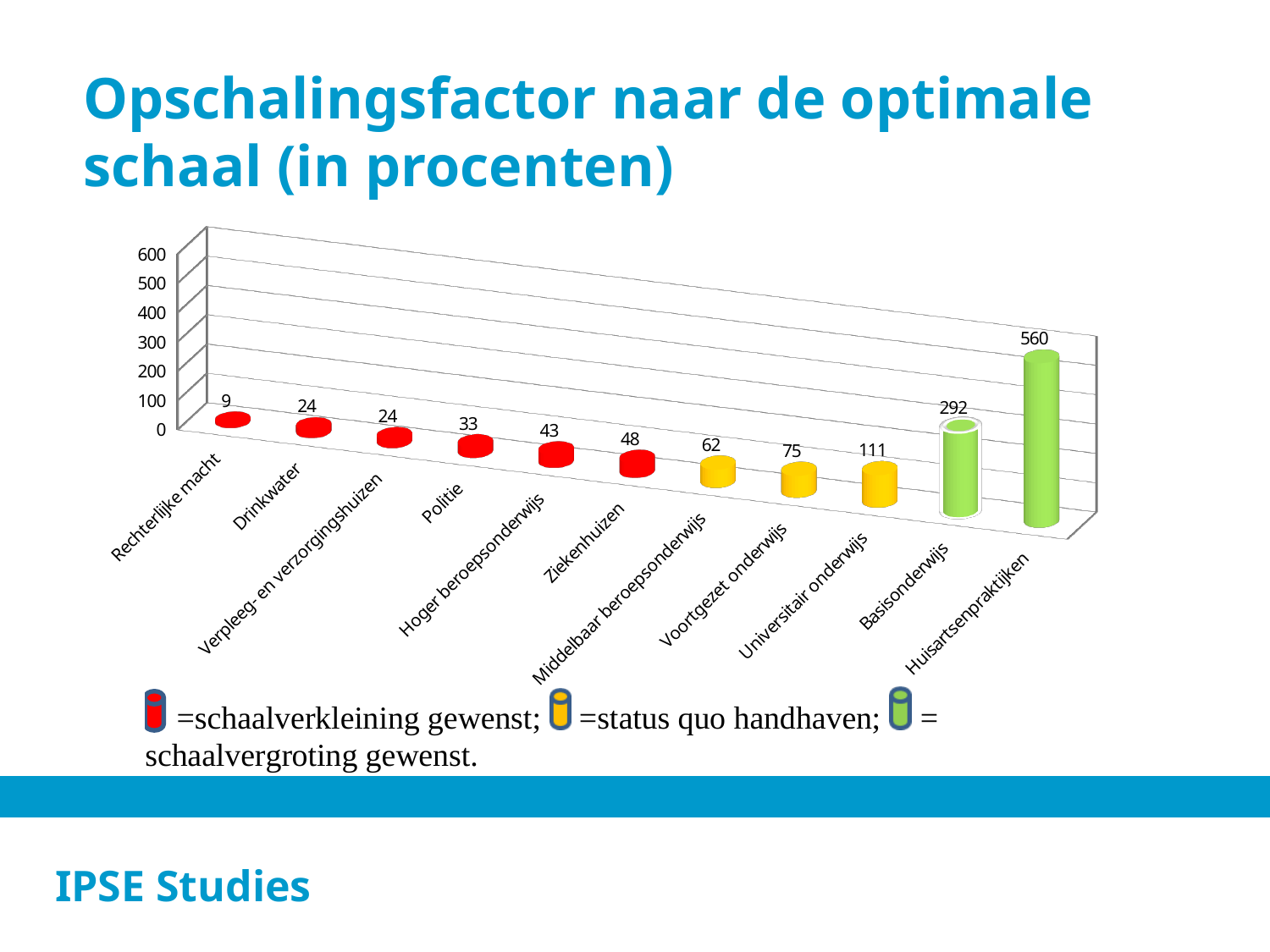
Do the values rise or fall from left to right along the x axis? Rise Which category has the highest value? Huisartsenpraktijken What colour are the bars for Basisonderwijs and Huisartsenpraktijken? Green What is the difference between the values for Huisartsenpraktijken and Basisonderwijs? 268 What is the value for Universitair onderwijs? 111 How many categories are shown on the x axis? 11 Which is larger, the value for Voortgezet onderwijs or the value for Ziekenhuizen? Voortgezet onderwijs What is the value for Huisartsenpraktijken? 560 Which category has the lowest value? Rechterlijke macht What kind of chart is shown on the slide? Bar chart What is the value for Politie? 33 What is the value for Basisonderwijs? 292